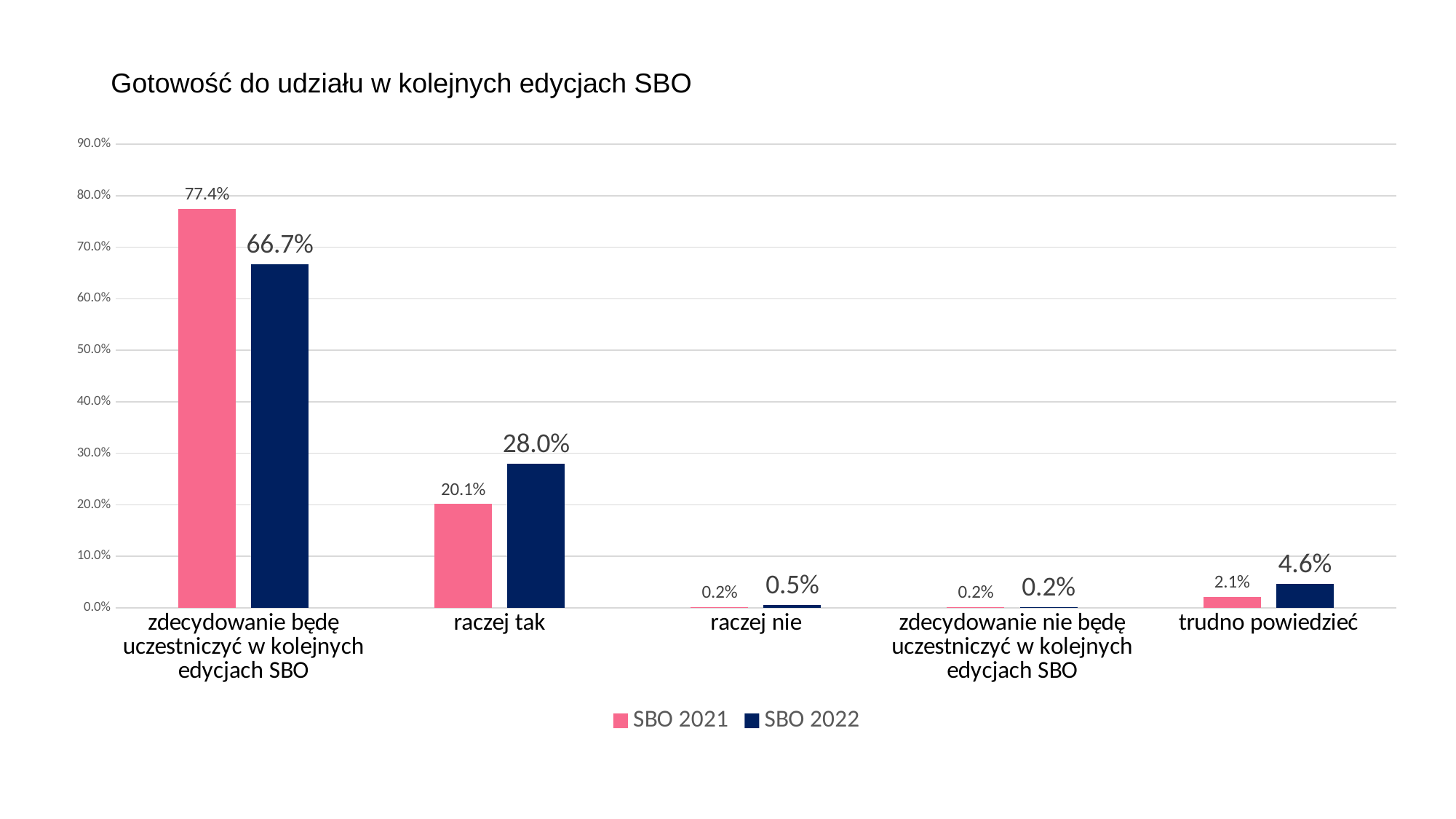
How many categories are shown on the x axis? 5 What is the SBO 2021 value for "raczej nie"? 0.2% Which category has the highest SBO 2022 value? zdecydowanie będę uczestniczyć w kolejnych edycjach SBO What kind of chart is shown on the slide? bar chart What is the SBO 2022 value for "raczej tak"? 28.0% For "trudno powiedzieć", which series has the larger value, SBO 2021 or SBO 2022? SBO 2022 What is the difference between the SBO 2022 and SBO 2021 values for "raczej tak"? 7.9% What is the SBO 2021 value for "zdecydowanie będę uczestniczyć w kolejnych edycjach SBO"? 77.4% How many series does the legend list? 2 What is the difference between the SBO 2021 and SBO 2022 values for "zdecydowanie będę uczestniczyć w kolejnych edycjach SBO"? 10.7% What is the title of the chart? Gotowość do udziału w kolejnych edycjach SBO What is the SBO 2022 value for "trudno powiedzieć"? 4.6%